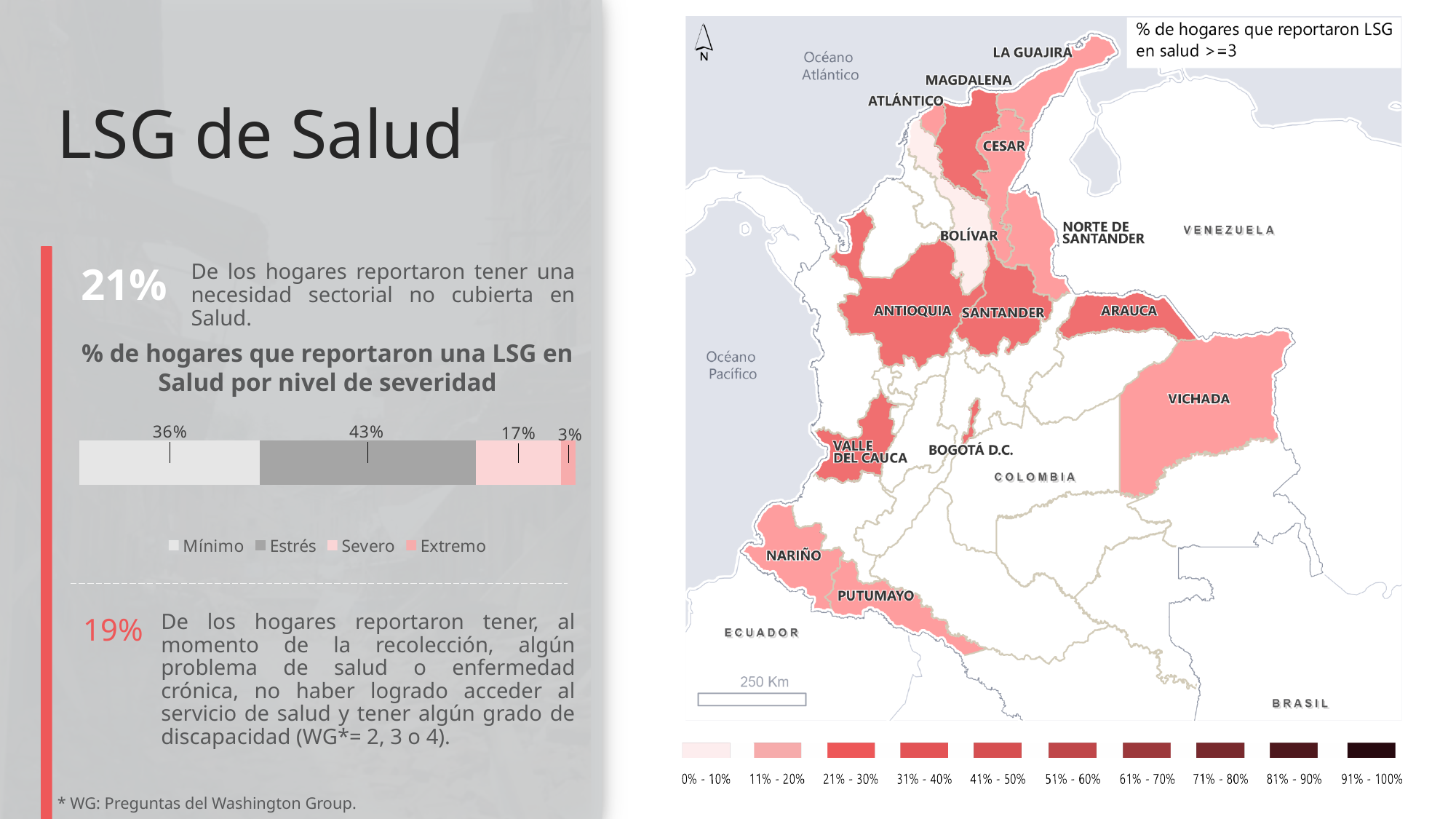
In the stacked bar chart on the left, what is the value for Extremo? 3% How many percentage ranges does the legend of the map on the right show? 10 In the stacked bar chart on the left, what is the value for Severo? 17% In the stacked bar chart on the left, what is the value for Mínimo? 36% In the stacked bar chart on the left, what is the difference between the Estrés and Mínimo values? 7% In the stacked bar chart on the left, what is the total of the four labelled segments? 99% How many series does the legend of the stacked bar chart on the left list? 4 What kind of chart is shown under the heading '% de hogares que reportaron una LSG en Salud por nivel de severidad'? Stacked bar chart In the stacked bar chart on the left, which severity level has the highest share? Estrés In the stacked bar chart on the left, which is larger, Severo or Extremo? Severo In the stacked bar chart on the left, which severity level has the lowest share? Extremo In the chart '% de hogares que reportaron una LSG en Salud por nivel de severidad', what is the value for Estrés? 43%